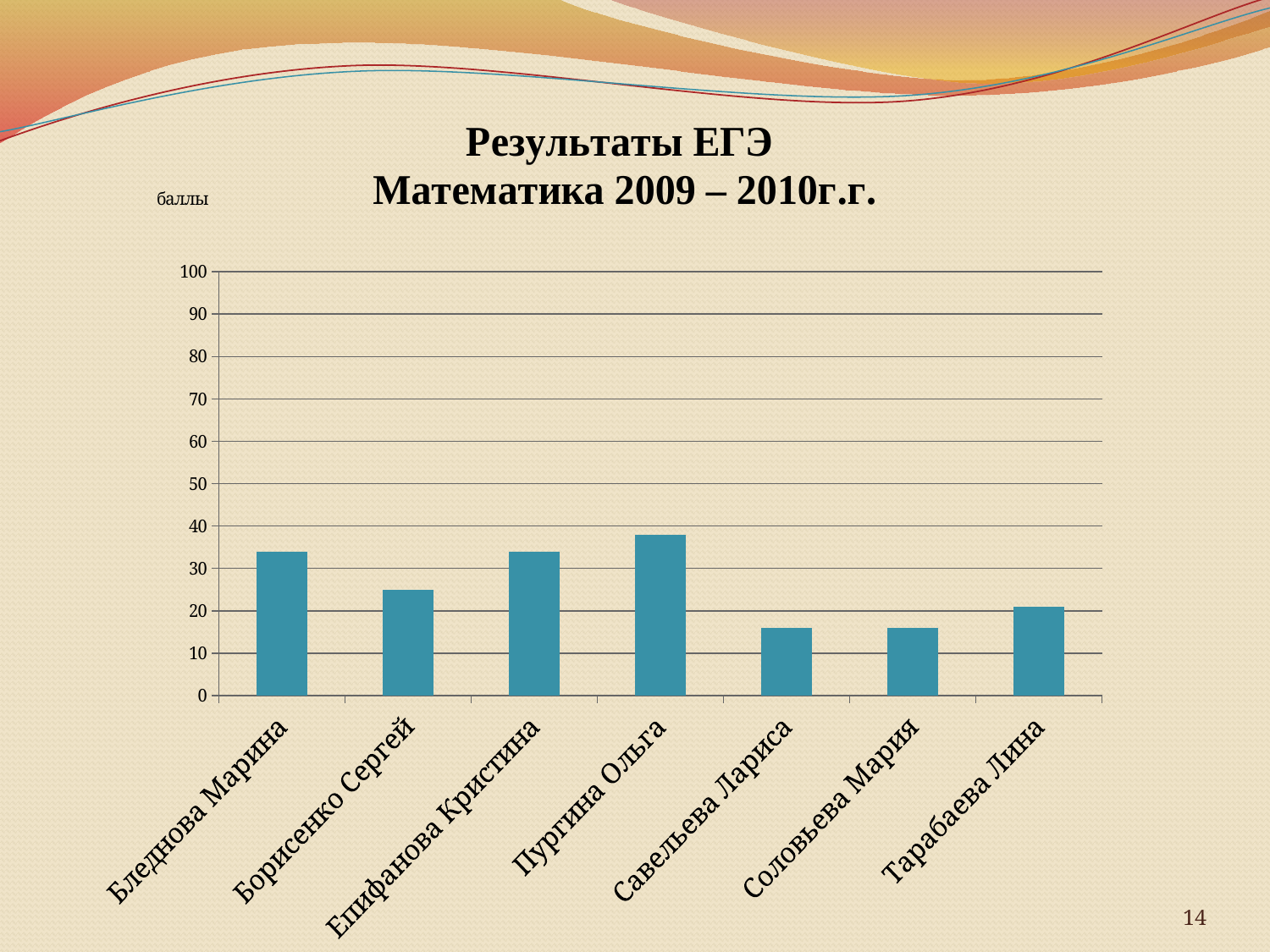
What label is shown for the vertical axis of the chart? баллы Which is larger, the value for Бледнова Марина or the value for Тарабаева Лина? Бледнова Марина Is the value for Борисенко Сергей greater or less than 30? less Is the value for Тарабаева Лина greater or less than 30? less Which student has the highest score in the chart? Пургина Ольга Which is larger, the value for Пургина Ольга or the value for Борисенко Сергей? Пургина Ольга Is the value for Бледнова Марина greater or less than 30? greater What is the title of the chart? Результаты ЕГЭ Математика 2009 – 2010г.г. What kind of chart is shown on the slide? bar chart How many students (categories) are shown on the x axis of the chart? 7